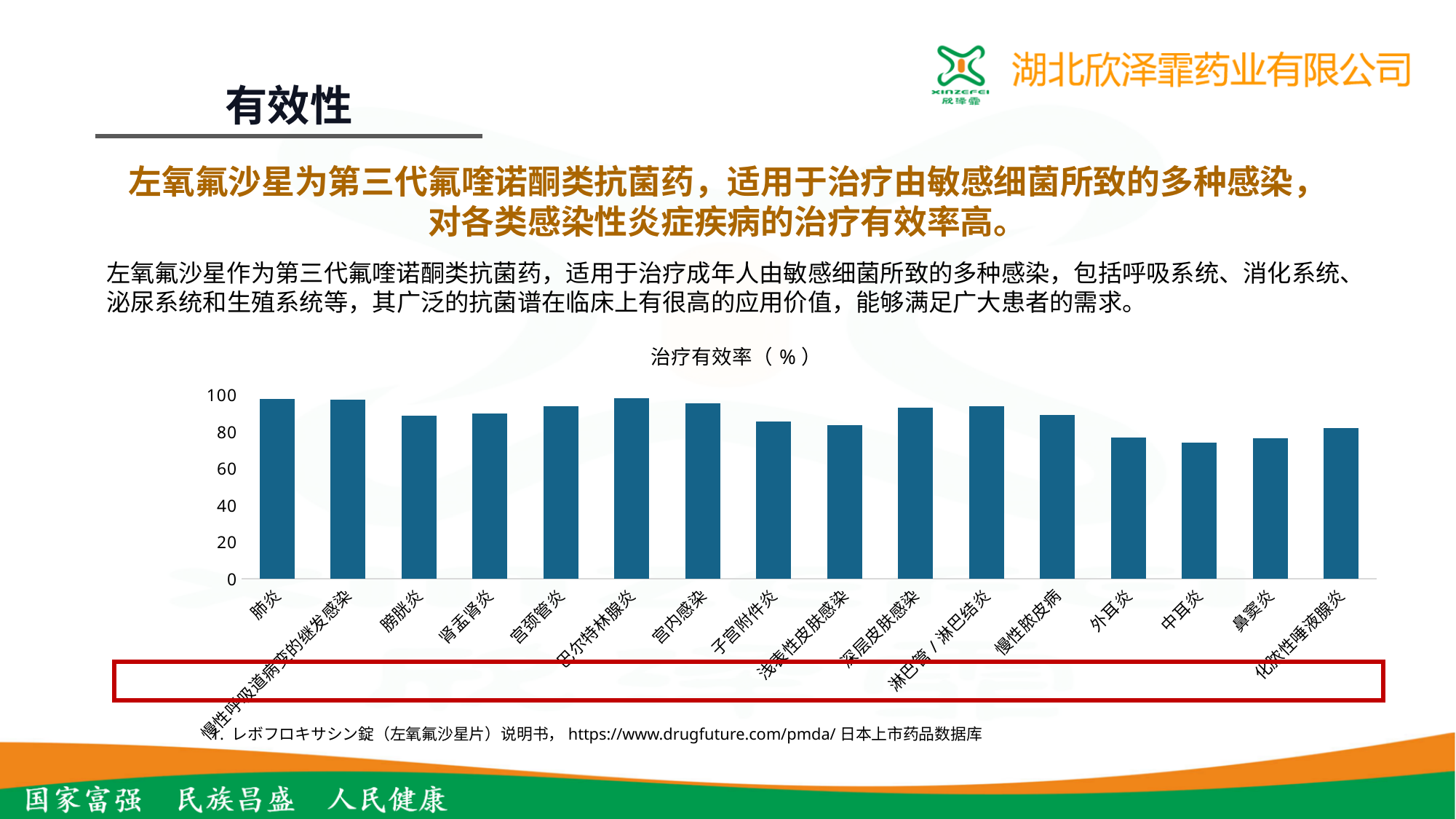
Which has a higher value, 肺炎 or 中耳炎? 肺炎 Is the value for 外耳炎 greater or less than 80? less Which has a higher value, 深层皮肤感染 or 浅表性皮肤感染? 深层皮肤感染 Is the value for 宫内感染 greater or less than 80? greater Is the value for 鼻窦炎 greater or less than 80? less What is the title of the chart? 治疗有效率（%） What kind of chart is shown on the slide? Bar chart How many categories (infection types) are plotted in the chart? 16 Which has a higher value, 宫内感染 or 外耳炎? 宫内感染